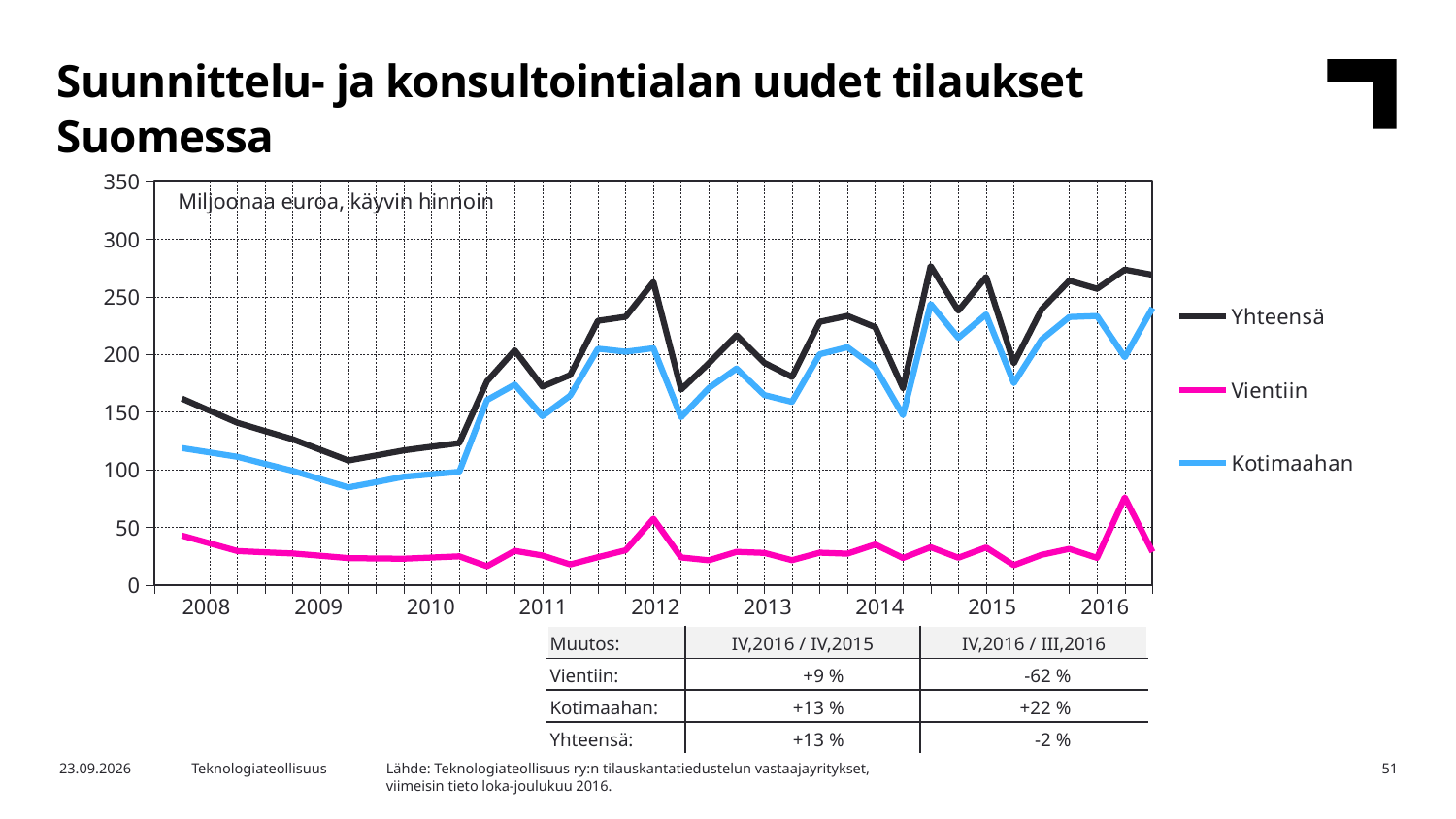
Is the value for Kotimaahan at the start of 2008 greater or less than 100? greater Is the value for Vientiin at the start of 2010 greater or less than 50? less Which is larger at the start of 2012, Kotimaahan or Vientiin? Kotimaahan How many years are labelled on the x axis? 9 Which series has the highest values throughout the chart? Yhteensä Does the Yhteensä line rise or fall from 2008 to 2009? fall How many series does the legend list? 3 What unit is stated in the text inside the chart area? Miljoonaa euroa, käyvin hinnoin Which series has the lowest values throughout the chart? Vientiin Is the highest value for Yhteensä in 2014 greater or less than 250? greater What are the three series named in the legend? Yhteensä, Vientiin, Kotimaahan What kind of chart is shown on the slide? line chart